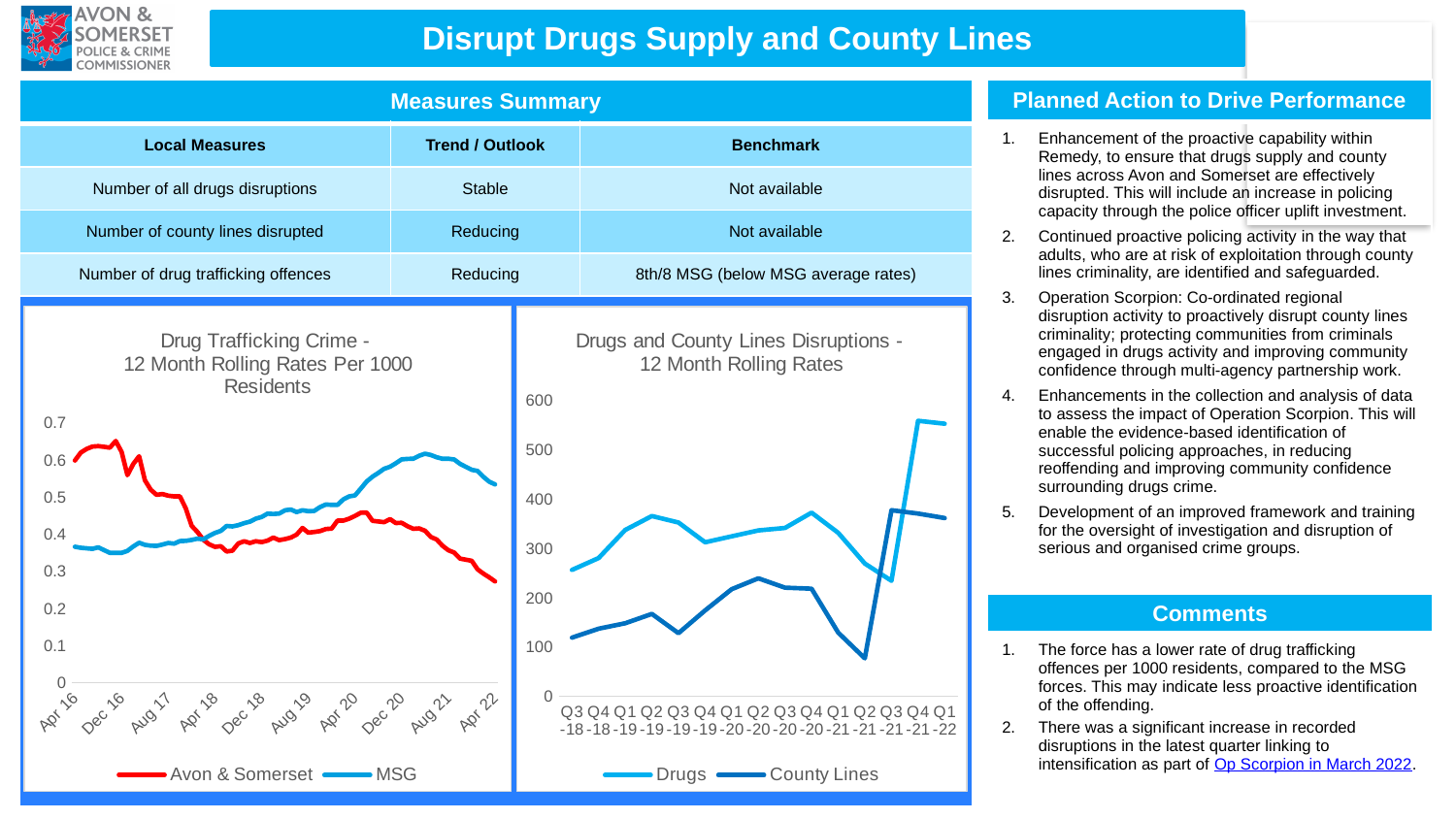
In the 'Drug Trafficking Crime' chart, is the Avon & Somerset value at Apr 22 greater or less than 0.4? less In the 'Drug Trafficking Crime' chart, which series is higher at Apr 22, Avon & Somerset or MSG? MSG In the 'Drugs and County Lines Disruptions' chart, is the Drugs value for Q4-21 greater or less than 500? greater What kind of chart is the 'Drug Trafficking Crime - 12 Month Rolling Rates Per 1000 Residents' chart? Line chart In the 'Drugs and County Lines Disruptions' chart, is the Drugs value for Q3-18 greater or less than 200? greater In the 'Drug Trafficking Crime' chart, does the Avon & Somerset line overall rise or fall from Apr 16 to Apr 22? Fall How many quarters are labelled on the x axis of the 'Drugs and County Lines Disruptions' chart? 15 How many series does the legend of the 'Drugs and County Lines Disruptions - 12 Month Rolling Rates' chart list? 2 In the 'Drug Trafficking Crime' chart, which two series are shown in the legend? Avon & Somerset and MSG In the 'Drugs and County Lines Disruptions' chart, which series is higher at Q1-22, Drugs or County Lines? Drugs